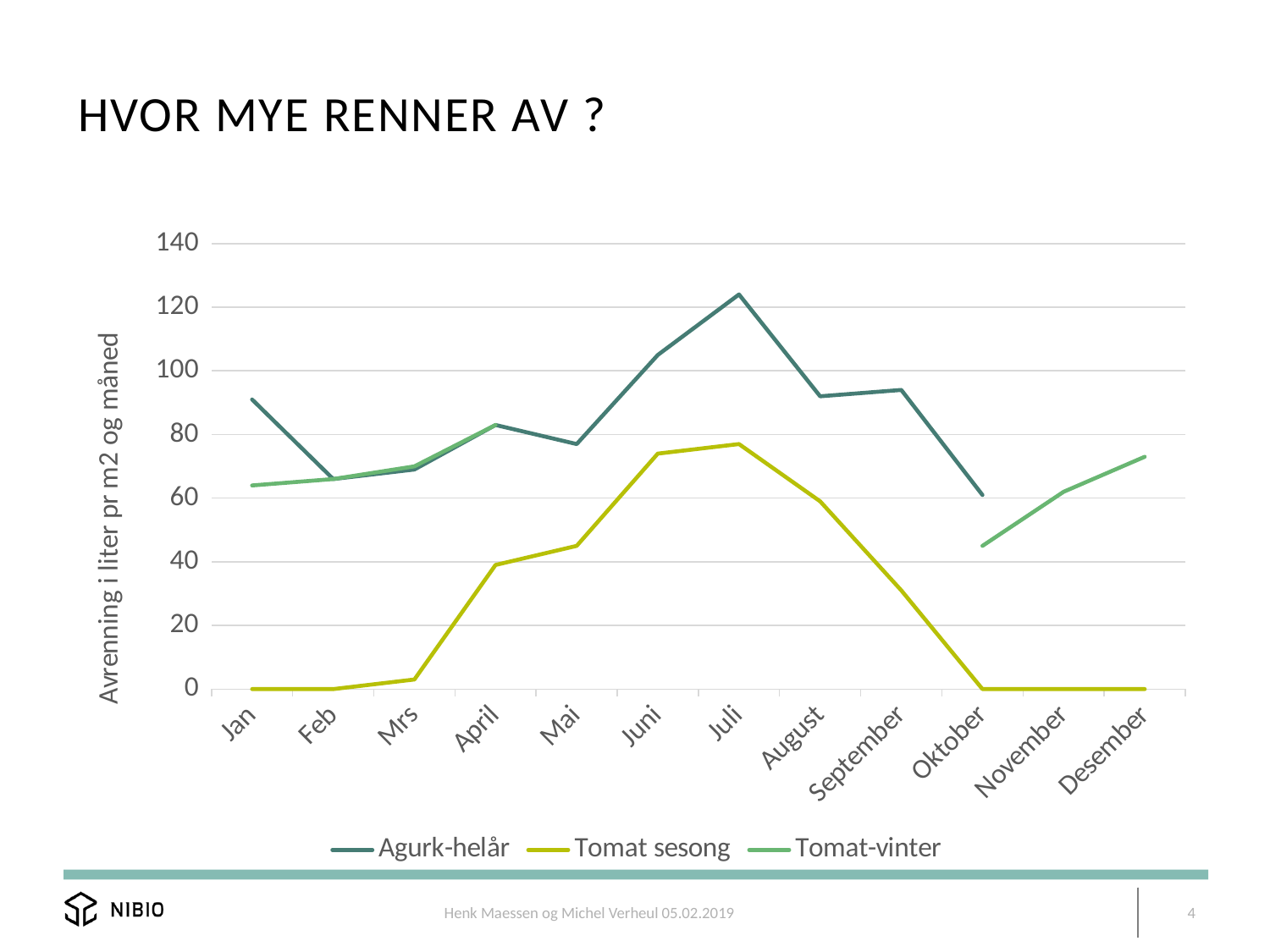
In which month is the value for Agurk-helår highest? Juli Which is larger in Juni, the value for Agurk-helår or the value for Tomat sesong? Agurk-helår Is the value for Tomat-vinter in Oktober greater or less than 60? less What kind of chart is shown on the slide? line chart What is the value for Tomat sesong in Jan? 0 How many series does the legend list? 3 What is the value for Tomat sesong in Desember? 0 Does the value for Tomat sesong rise or fall from April to Juli? rise What is the title of the y axis? Avrenning i liter pr m2 og måned How many months are shown along the x axis? 12 Is the value for Agurk-helår in Juli greater or less than 100? greater In which month is the value for Tomat sesong highest? Juli